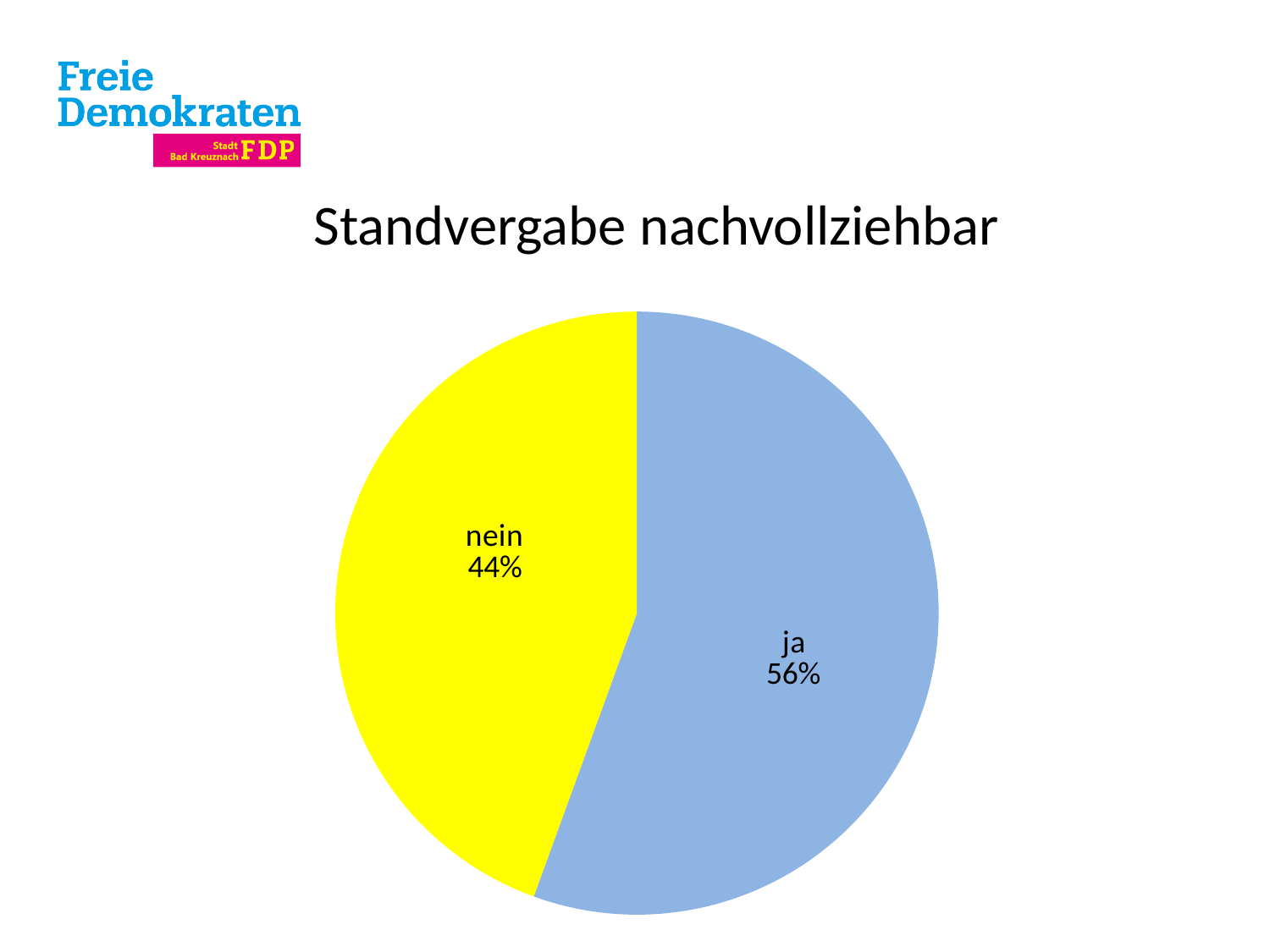
What colour is the "nein" slice? yellow What is the title of the chart? Standvergabe nachvollziehbar Is the share for "ja" greater or less than 50%? greater Which slice of the pie is the smallest? nein What is the difference in percentage points between the "ja" and "nein" slices? 12 Which slice of the pie is the largest? ja How many slices does the pie chart have? 2 What share of the pie is labelled "nein"? 44% What kind of chart is shown on the slide? pie chart Which slice is larger, "ja" or "nein"? ja What share of the pie is labelled "ja"? 56%